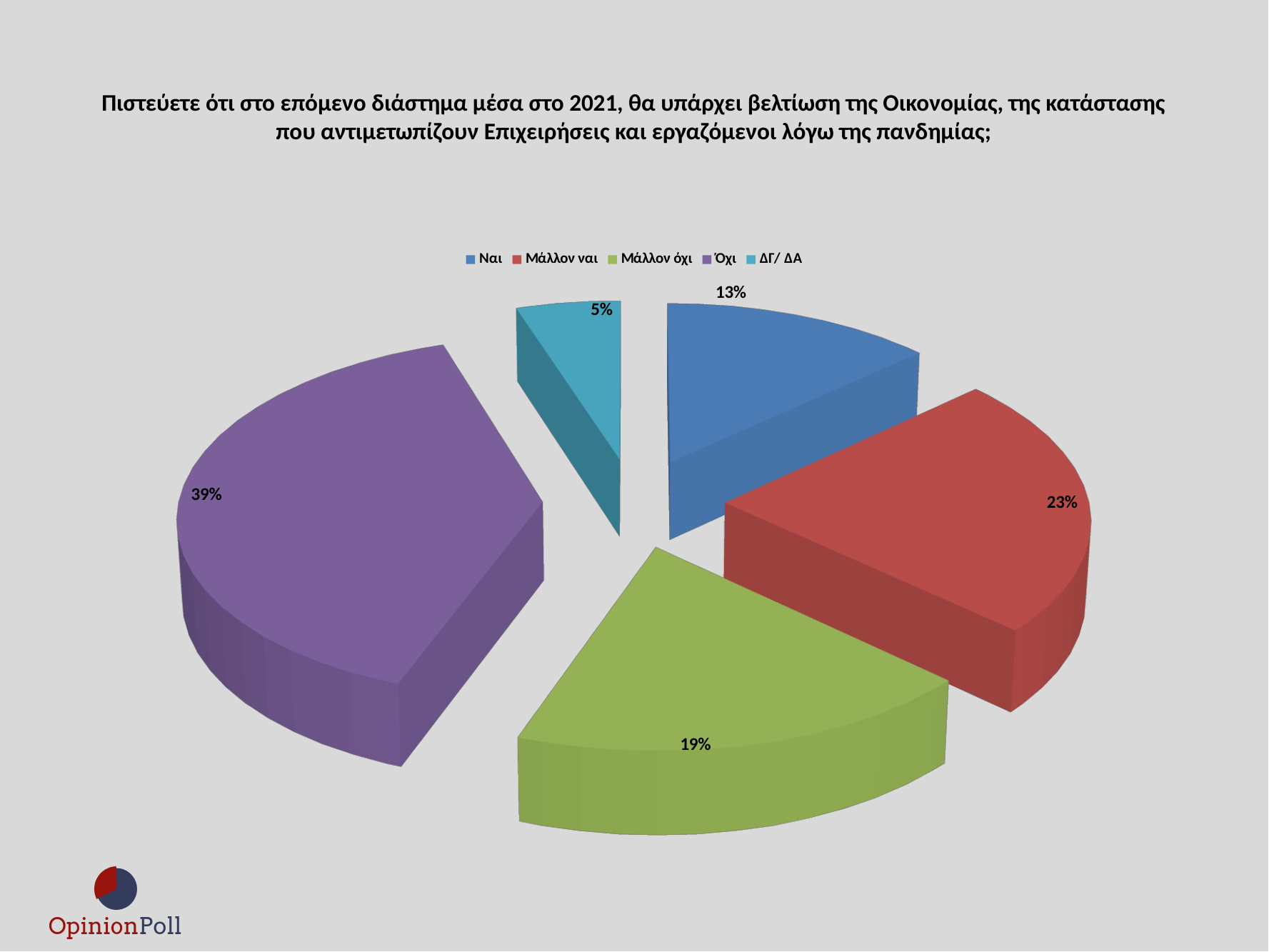
What percentage of the pie is the 'Μάλλον όχι' slice? 19% What percentage of the pie is the 'Μάλλον ναι' slice? 23% What percentage of the pie is the 'ΔΓ/ ΔΑ' slice? 5% How many slices does the pie chart have? 5 Which category has the smallest share of the pie? ΔΓ/ ΔΑ What kind of chart is shown on the slide? Pie chart Which is larger, the 'Μάλλον ναι' slice or the 'Μάλλον όχι' slice? Μάλλον ναι What percentage of the pie is the 'Όχι' slice? 39% What colour is the 'Όχι' slice in the pie chart? Purple Which category has the largest share of the pie? Όχι What percentage of the pie is the 'Ναι' slice? 13% What is the difference in percentage points between the 'Όχι' and 'Μάλλον ναι' slices? 16